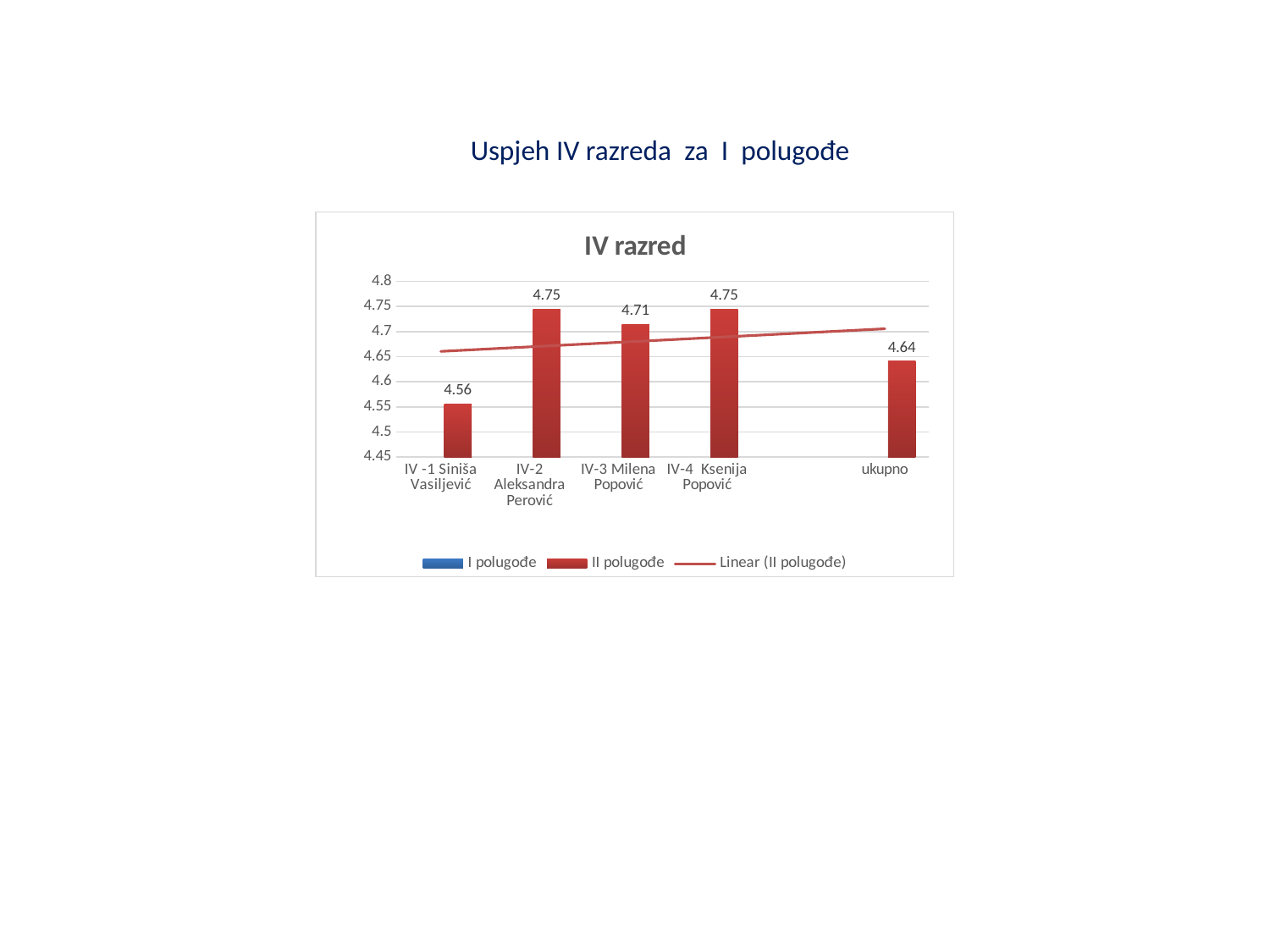
What kind of chart is shown? bar chart What is the value for IV -1 Siniša Vasiljević? 4.56 Which is larger, the value for IV-3 Milena Popović or the value for ukupno? IV-3 Milena Popović What is the value for ukupno? 4.64 Is the value for IV -1 Siniša Vasiljević greater or less than 4.6? less What is the difference between the values for IV-4 Ksenija Popović and IV -1 Siniša Vasiljević? 0.19 What is the difference between the values for IV-3 Milena Popović and ukupno? 0.07 What is the value for IV-2 Aleksandra Perović? 4.75 Which category has the lowest value? IV -1 Siniša Vasiljević What is the value for IV-3 Milena Popović? 4.71 How many entries does the legend list? 3 How many categories are shown on the x axis? 5